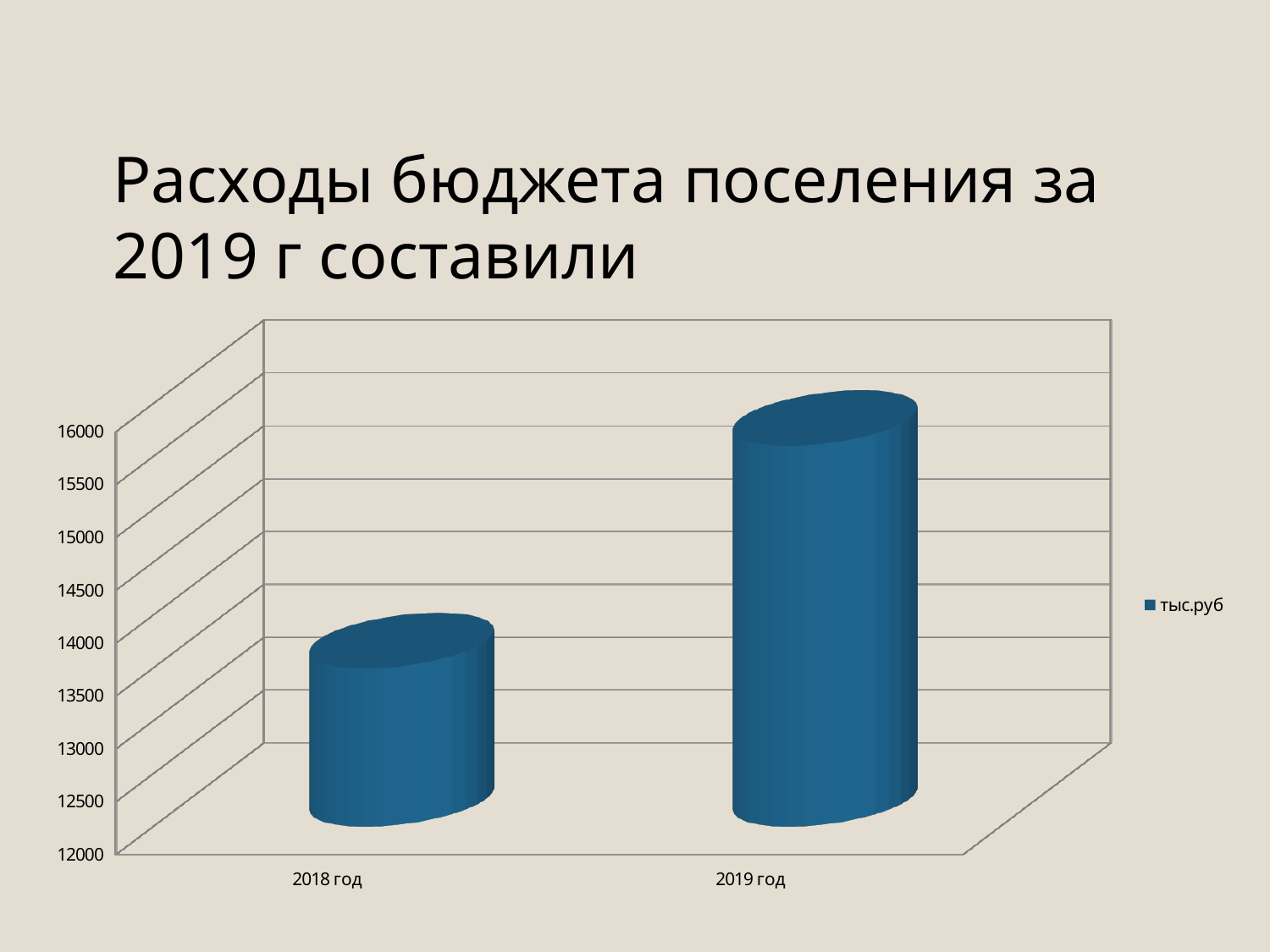
Is the value for 2018 год greater or less than 13000? greater How many categories are plotted on the x axis of the chart? 2 Which category has the lowest value in the chart? 2018 год Is the value for 2018 год greater or less than 15000? less What is the legend entry of the chart? тыс.руб What is the title of the slide containing the chart? Расходы бюджета поселения за 2019 г составили Which is larger, the value for 2018 год or the value for 2019 год? 2019 год Which category has the highest value in the chart? 2019 год Do the values rise or fall from 2018 год to 2019 год? rise What kind of chart is shown on the slide? bar chart Is the value for 2019 год greater or less than 15000? greater How many series does the chart's legend list? 1